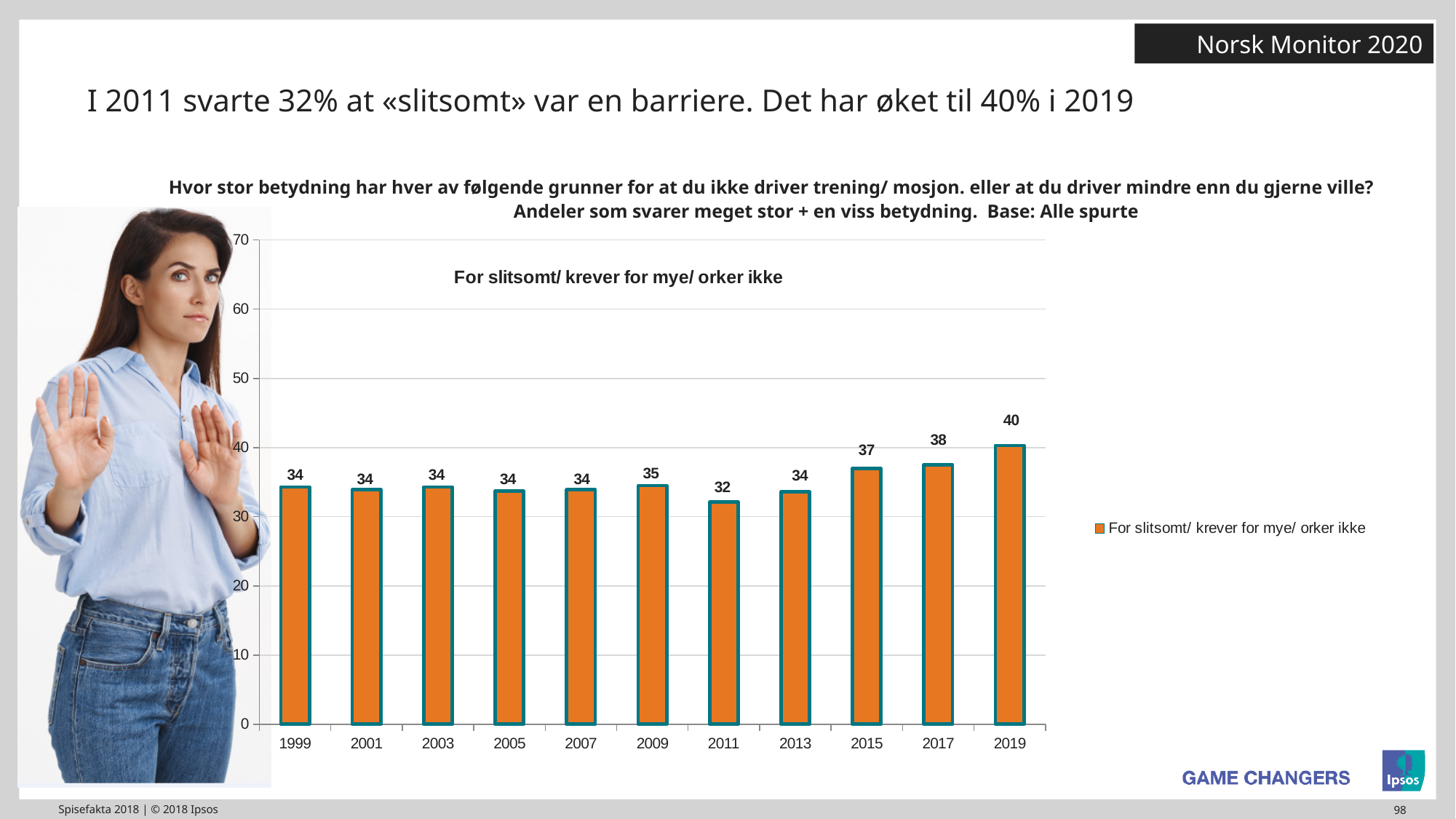
What is the series name shown in the legend? For slitsomt/ krever for mye/ orker ikke How many years are shown on the x axis? 11 Which year has the lowest value? 2011 Which is larger, the value for 2015 or the value for 2009? 2015 What kind of chart is shown? bar chart What is the value for 2009? 35 What is the value for 2019? 40 Which year has the highest value? 2019 What is the value for 2011? 32 What is the difference between the values for 2019 and 2011? 8 How many series does the legend list? 1 What is the value for 2017? 38